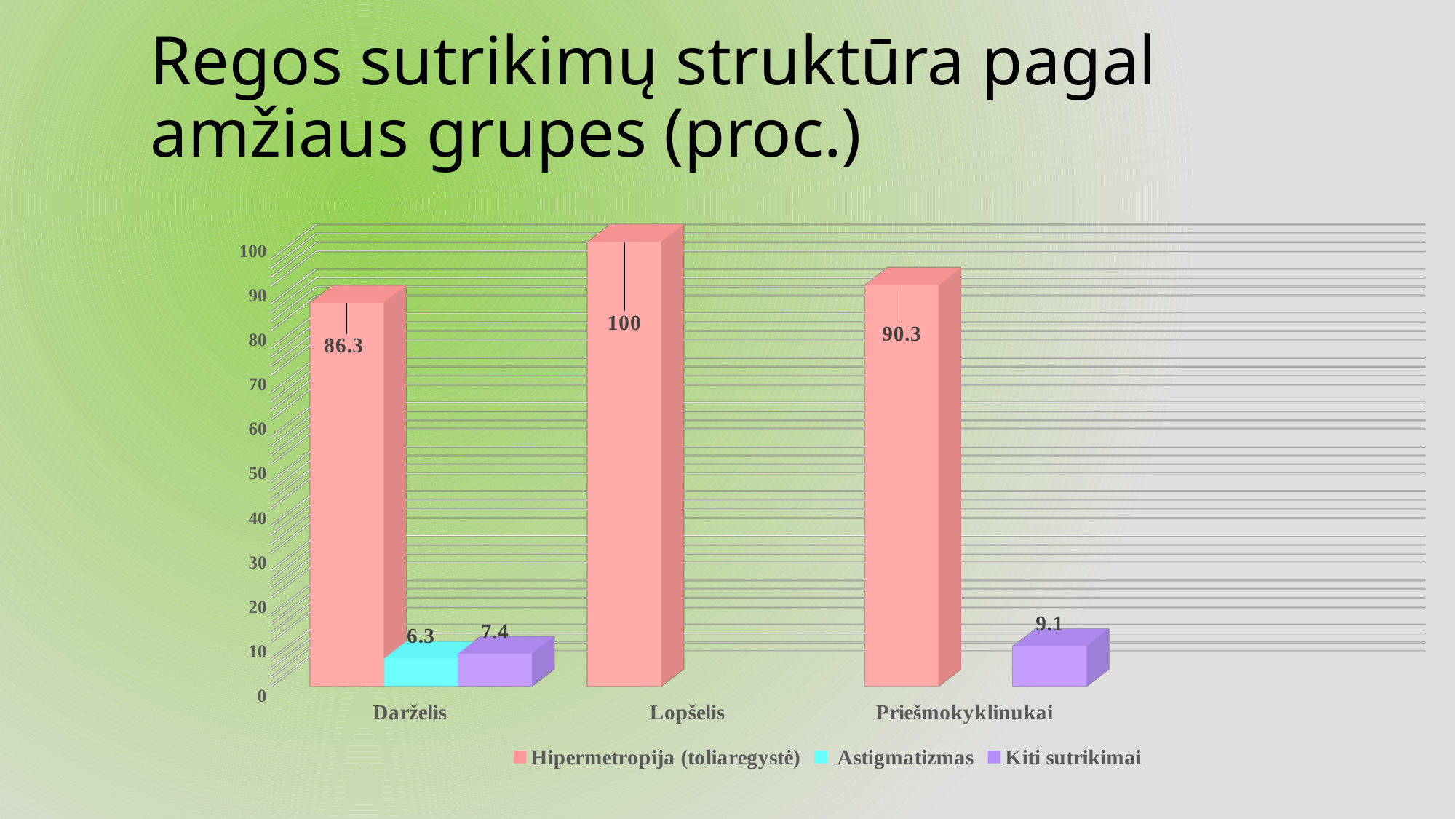
What is the difference between the Hipermetropija (toliaregystė) values for Lopšelis and Darželis? 13.7 What is the value for Hipermetropija (toliaregystė) in the Lopšelis group? 100 What kind of chart is shown on the slide? Bar chart How many series does the legend list? 3 Is the value for Hipermetropija (toliaregystė) in the Priešmokyklinukai group greater or less than 80? greater Which age group has the lowest value for Hipermetropija (toliaregystė)? Darželis What is the value for Kiti sutrikimai in the Priešmokyklinukai group? 9.1 In the Darželis group, which is larger: Astigmatizmas or Kiti sutrikimai? Kiti sutrikimai What is the value for Hipermetropija (toliaregystė) in the Darželis group? 86.3 What is the value for Astigmatizmas in the Darželis group? 6.3 Which age group has the highest value for Hipermetropija (toliaregystė)? Lopšelis How many age groups are shown on the x axis? 3